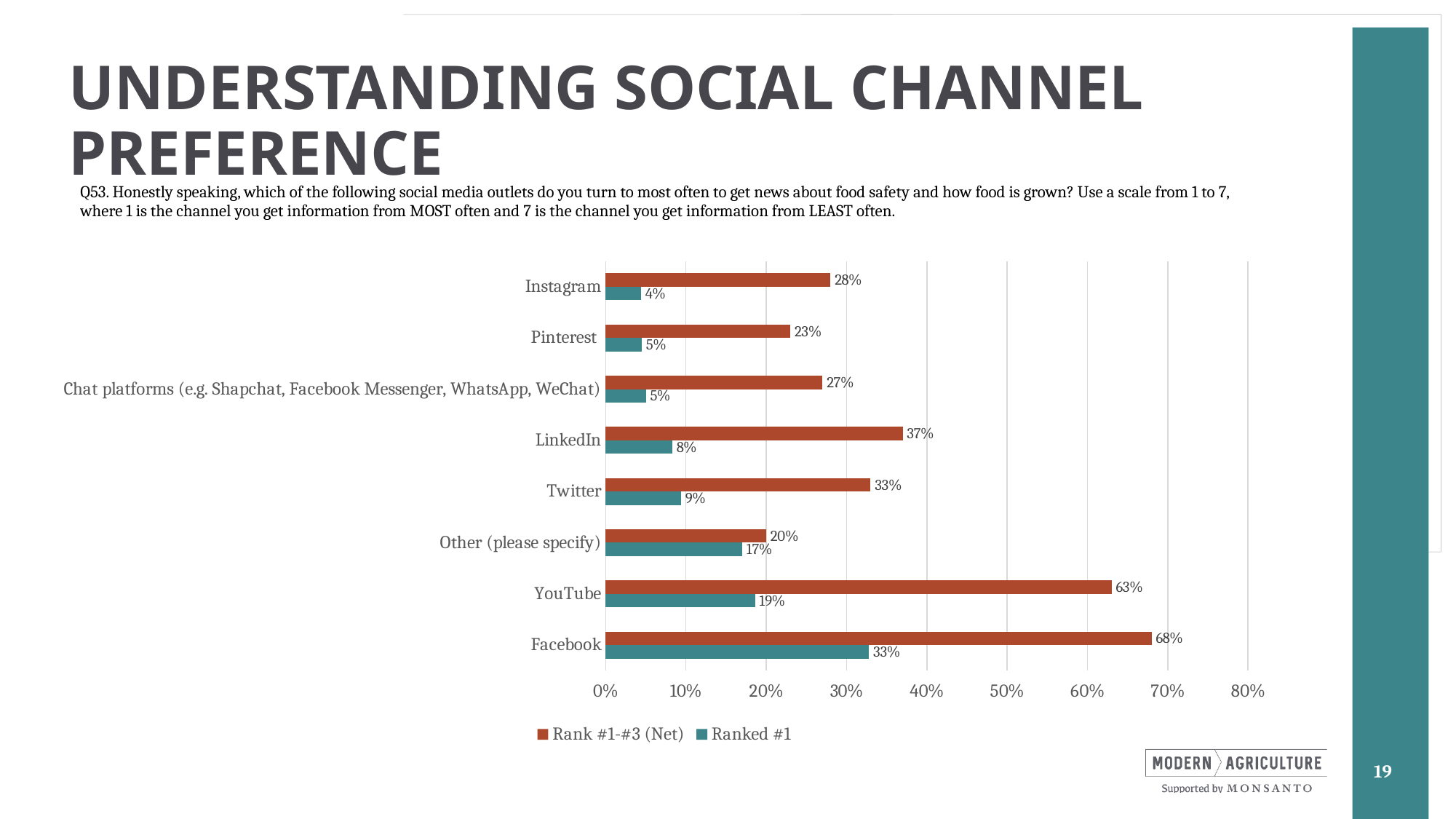
Which is larger, the Rank #1-#3 (Net) value for LinkedIn or for Twitter? LinkedIn What is the Ranked #1 value for YouTube? 19% What is the Rank #1-#3 (Net) value for Facebook? 68% What is the difference between the Rank #1-#3 (Net) values for Facebook and YouTube? 5% Is the Rank #1-#3 (Net) value for YouTube greater or less than 50%? greater What is the Ranked #1 value for LinkedIn? 8% How many categories are shown on the chart? 8 Which category has the highest Rank #1-#3 (Net) value? Facebook What are the two series named in the legend? Rank #1-#3 (Net) and Ranked #1 Which category has the lowest Ranked #1 value? Instagram What kind of chart is shown on the slide? Bar chart How many series does the legend list? 2